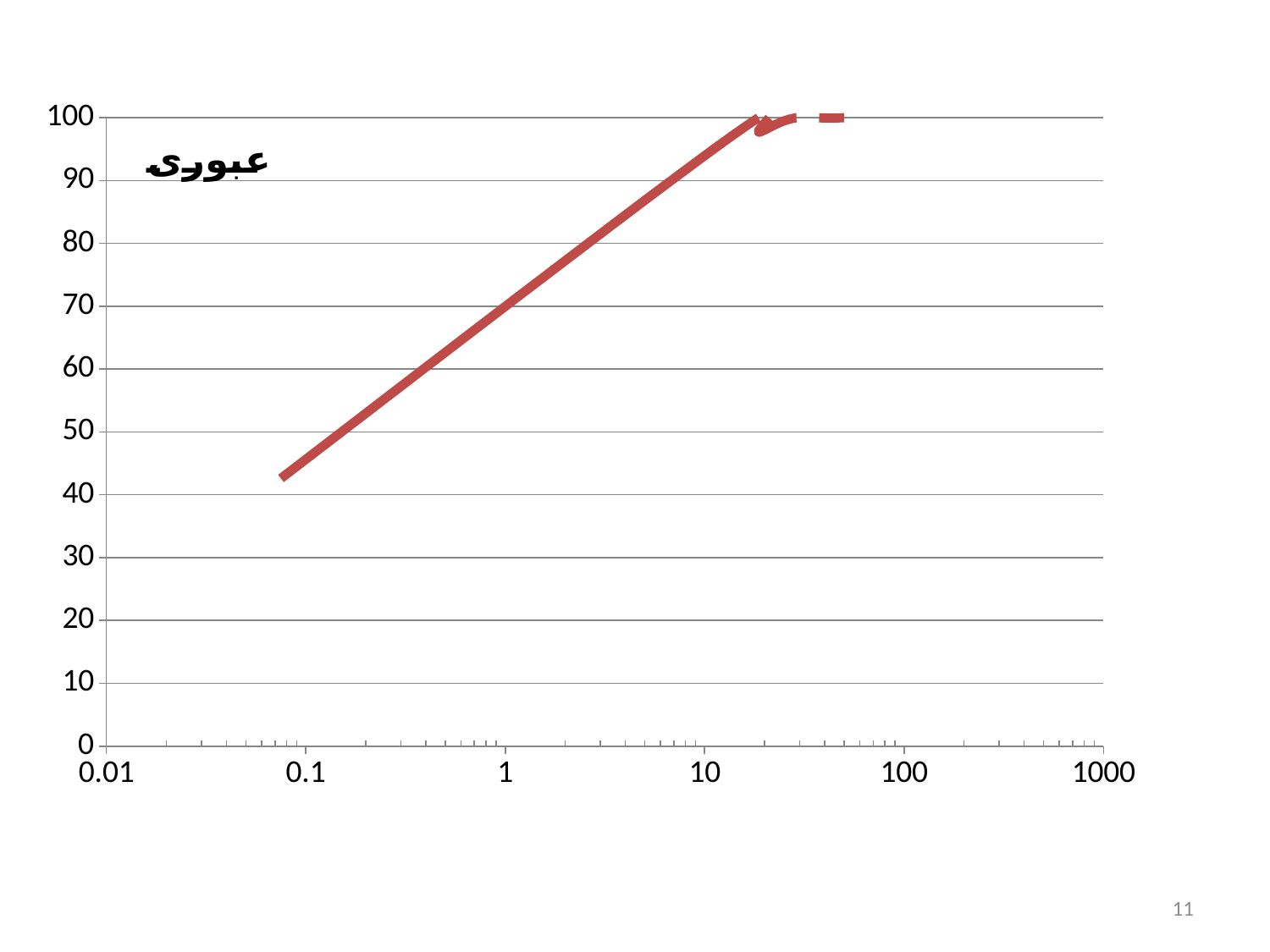
Is the plotted value at x = 0.1 greater or less than 60? less Is the plotted value at x = 0.1 greater or less than 40? greater What text label appears inside the plot area near the top left? عبوری Do the plotted values rise or fall as the x-axis value increases? rise Is the plotted value at x = 10 greater or less than 90? greater What is the highest value shown on the y-axis? 100 What kind of chart is shown on the slide? line chart